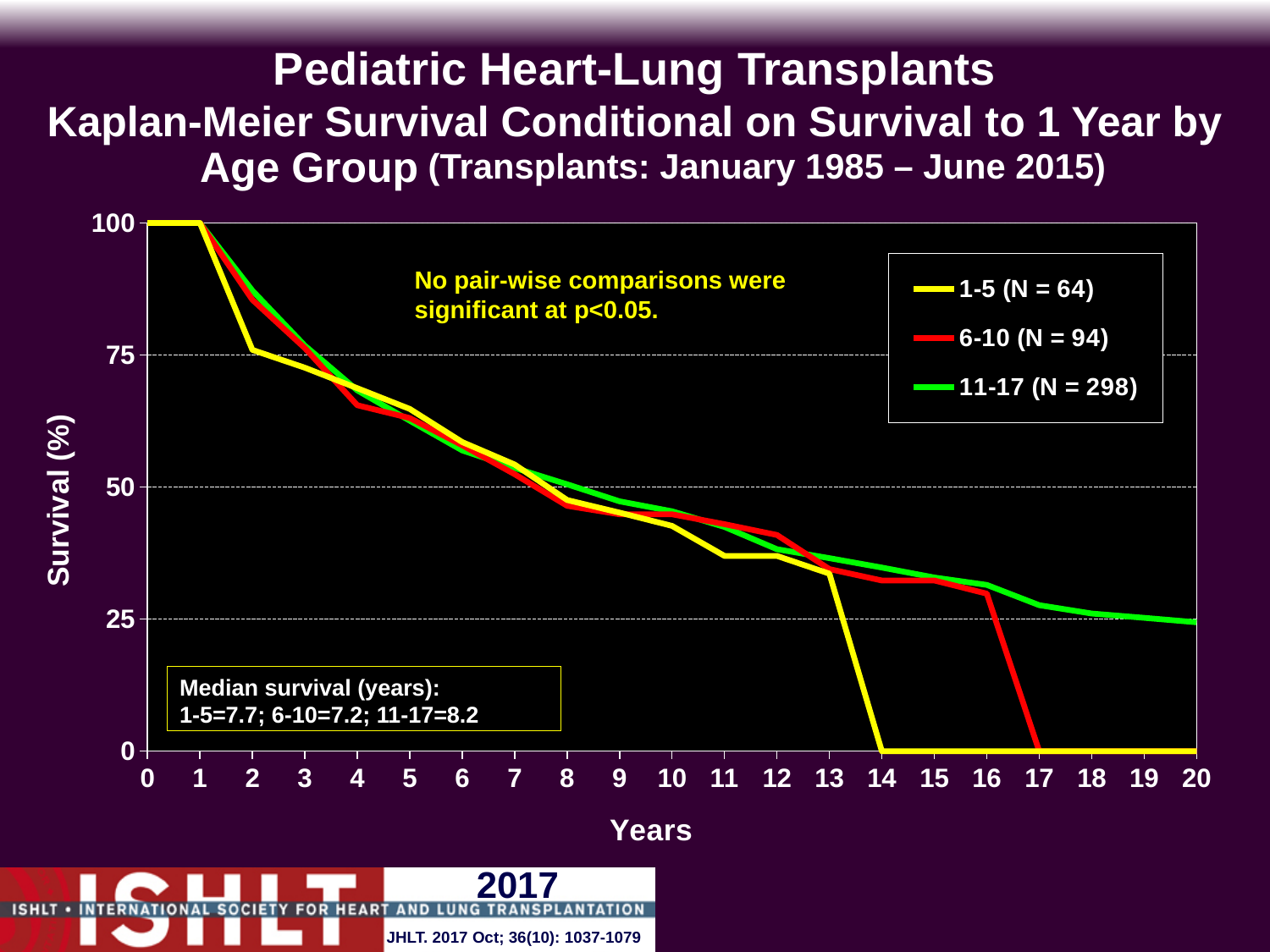
Which age group has the lowest median survival? 6-10 Is the survival value for the 6-10 age group at year 12 greater or less than 50? less At year 18, which age group has higher survival, 11-17 or 6-10? 11-17 Is the survival value for the 1-5 age group at year 4 greater or less than 75? less What is the difference in median survival (years) between the 11-17 and 6-10 age groups? 1.0 What is the N for the 11-17 age group? 298 What kind of chart is shown on the slide? line chart What is the median survival in years for the 6-10 age group? 7.2 Do the survival curves rise or fall as years increase? fall How many age-group series does the legend list? 3 What is the N for the 1-5 age group? 64 Which age group has the highest median survival? 11-17